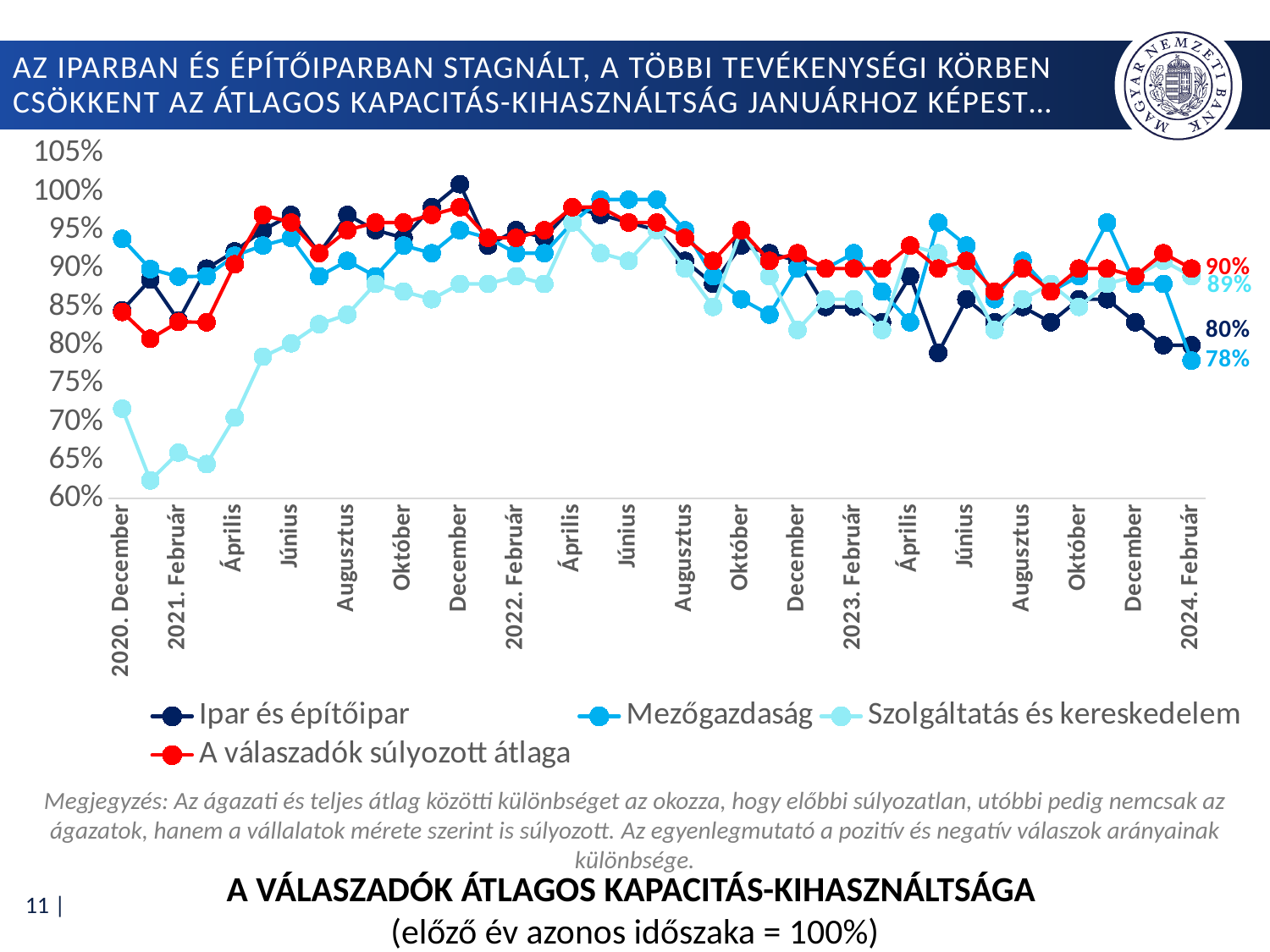
Which series has the lowest value in 2024. Február? Mezőgazdaság What is the value for 'A válaszadók súlyozott átlaga' in 2024. Február? 90% Which series is drawn in red? A válaszadók súlyozott átlaga What type of chart is shown on the slide? line chart What is the value for 'Szolgáltatás és kereskedelem' in 2024. Február? 89% How many series does the legend list? 4 What is the value for 'Ipar és építőipar' in 2024. Február? 80% What is the difference between 'A válaszadók súlyozott átlaga' and 'Mezőgazdaság' in 2024. Február? 12 percentage points Is the value for 'Szolgáltatás és kereskedelem' in 2020. December greater or less than 75%? less Which series has the highest value in 2024. Február? A válaszadók súlyozott átlaga Does the 'Szolgáltatás és kereskedelem' series rise or fall between 2020. December and 2022. Április? rise What is the value for 'Mezőgazdaság' in 2024. Február? 78%